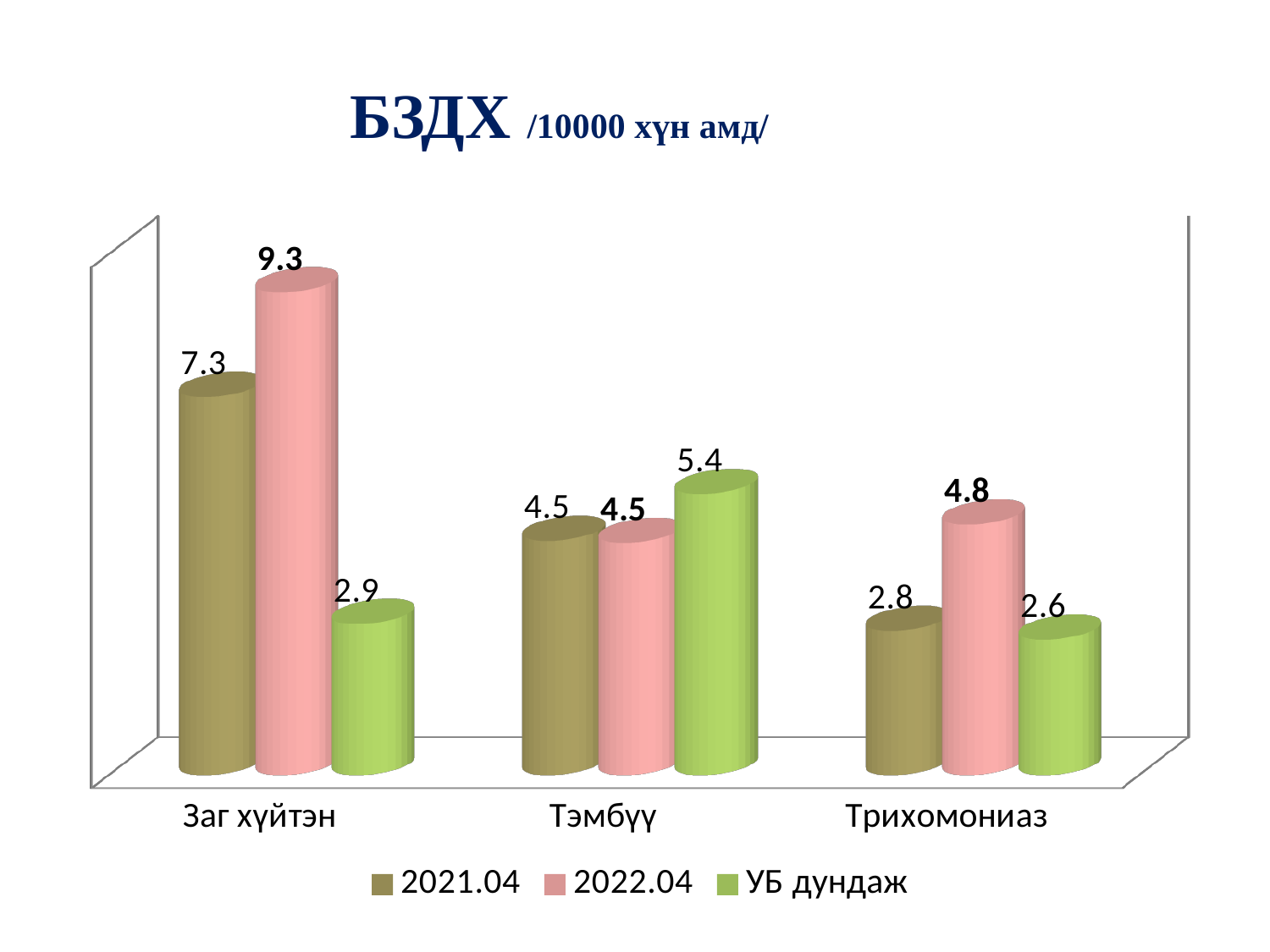
What is the value for Заг хүйтэн in the 2022.04 series? 9.3 What is the difference between the 2022.04 and 2021.04 values for Трихомониаз? 2.0 What is the value for Тэмбүү in the УБ дундаж series? 5.4 How many categories are shown on the x axis? 3 What is the difference between the 2022.04 and 2021.04 values for Заг хүйтэн? 2.0 What is the value for Трихомониаз in the 2021.04 series? 2.8 What is the title of the chart? БЗДХ /10000 хүн амд/ Which is larger for Тэмбүү: the 2022.04 value or the УБ дундаж value? УБ дундаж Which category has the lowest value in the УБ дундаж series? Трихомониаз What kind of chart is shown on the slide? Bar chart Which category has the highest value in the 2022.04 series? Заг хүйтэн How many series does the legend list? 3